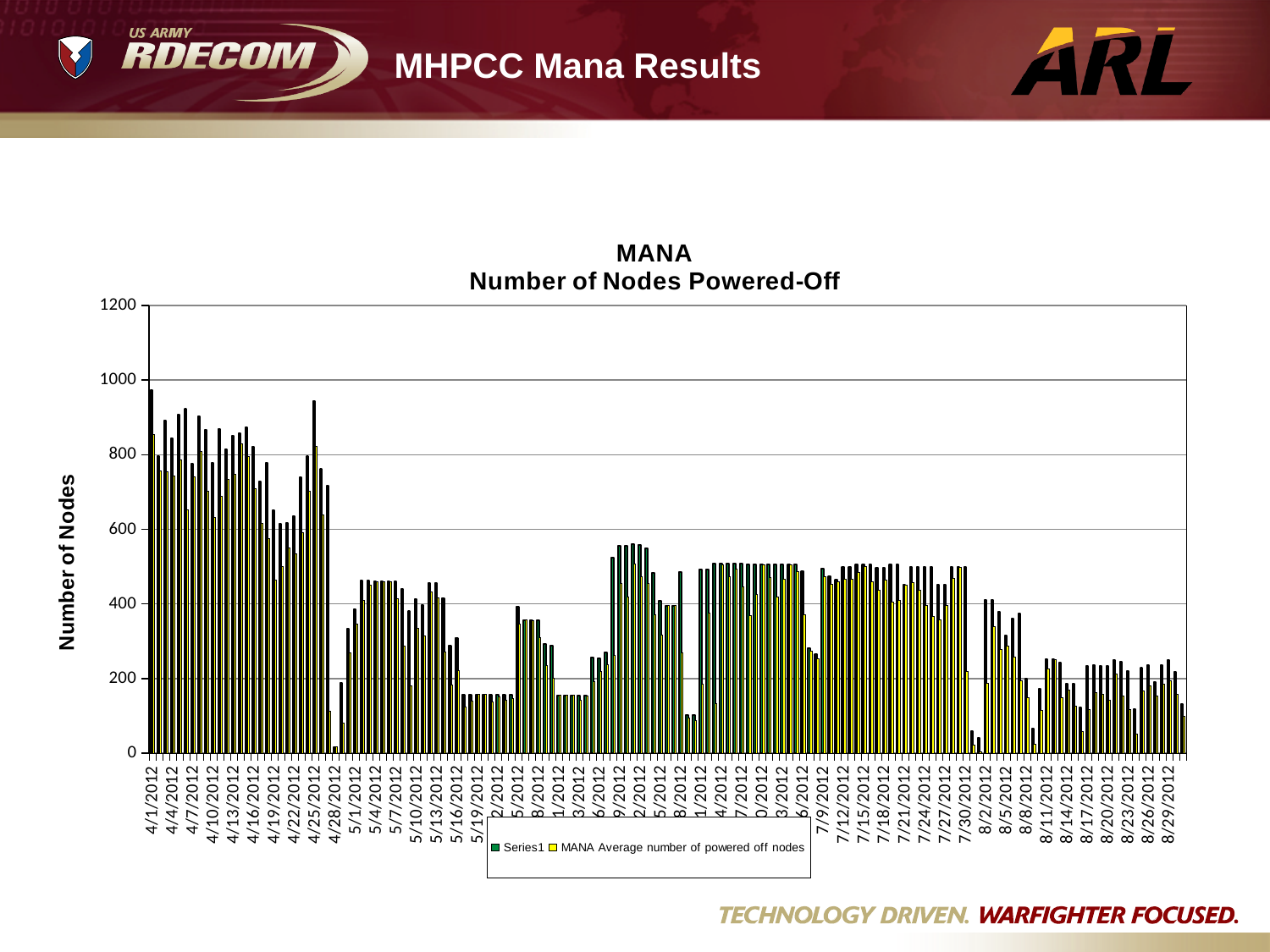
What kind of chart is shown on the slide? bar chart Is the value for 7/9/2012 greater or less than 400? greater Is the value for 5/19/2012 greater or less than 200? less Do the values generally rise or fall from April 2012 to August 2012? fall Is the value for 4/1/2012 greater or less than 800? greater Which is larger, the value for 4/1/2012 or the value for 8/29/2012? 4/1/2012 What is the label on the vertical axis? Number of Nodes What is the title of the chart? MANA Number of Nodes Powered-Off How many series does the legend list? 2